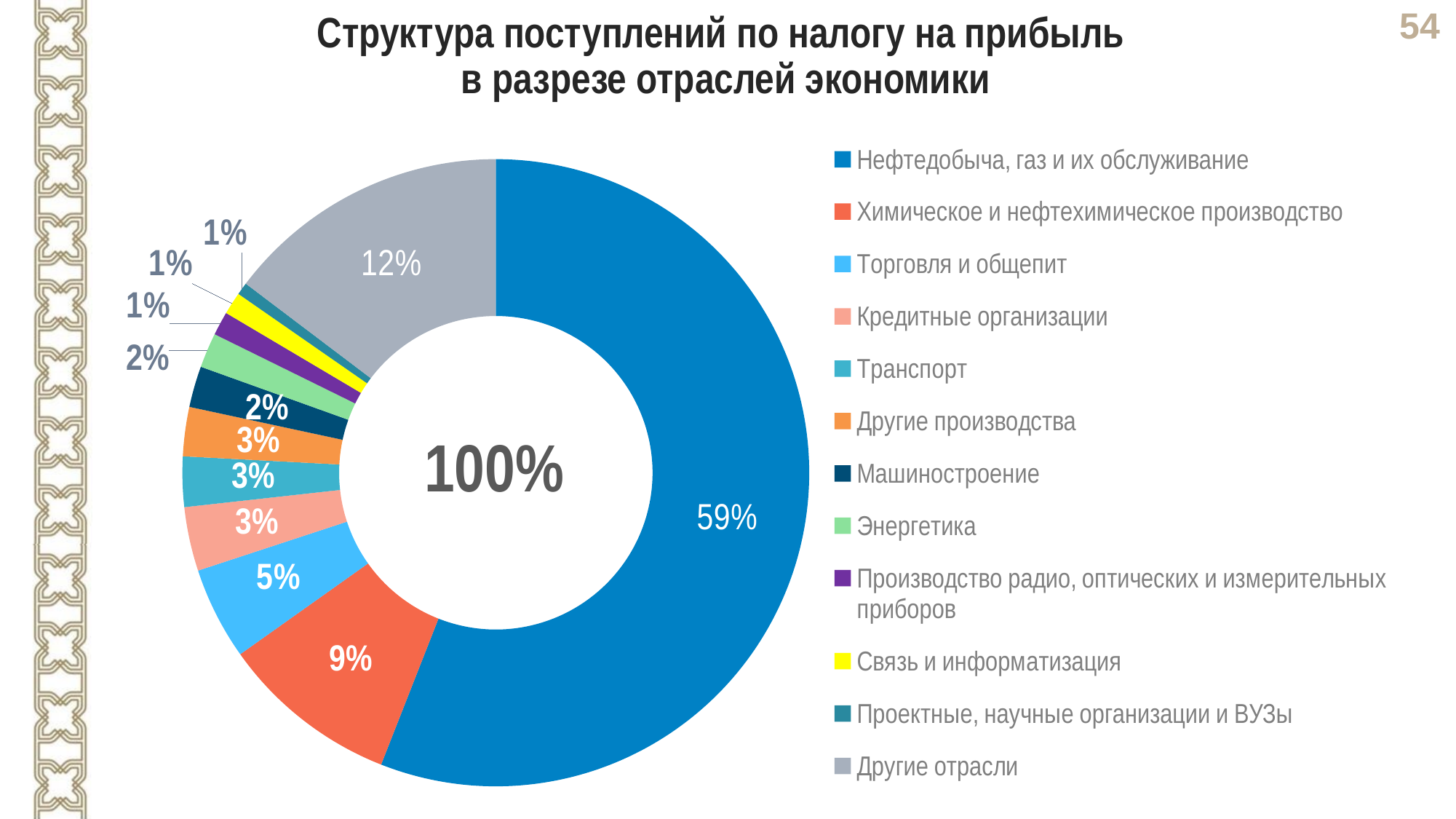
Which sector has the largest share of profit tax receipts? Нефтедобыча, газ и их обслуживание What share is shown for «Химическое и нефтехимическое производство»? 9% What is the difference between the shares of «Нефтедобыча, газ и их обслуживание» and «Другие отрасли»? 47 percentage points Which has a larger share: «Химическое и нефтехимическое производство» or «Торговля и общепит»? Химическое и нефтехимическое производство What is the title of the chart? Структура поступлений по налогу на прибыль в разрезе отраслей экономики What share is shown for «Машиностроение»? 2% How many sectors does the legend list? 12 What value is printed in the centre of the chart? 100% What share is shown for «Другие отрасли»? 12% What share is shown for «Торговля и общепит»? 5% What kind of chart is shown on the slide? Doughnut (pie) chart What share of profit tax receipts comes from «Нефтедобыча, газ и их обслуживание»? 59%